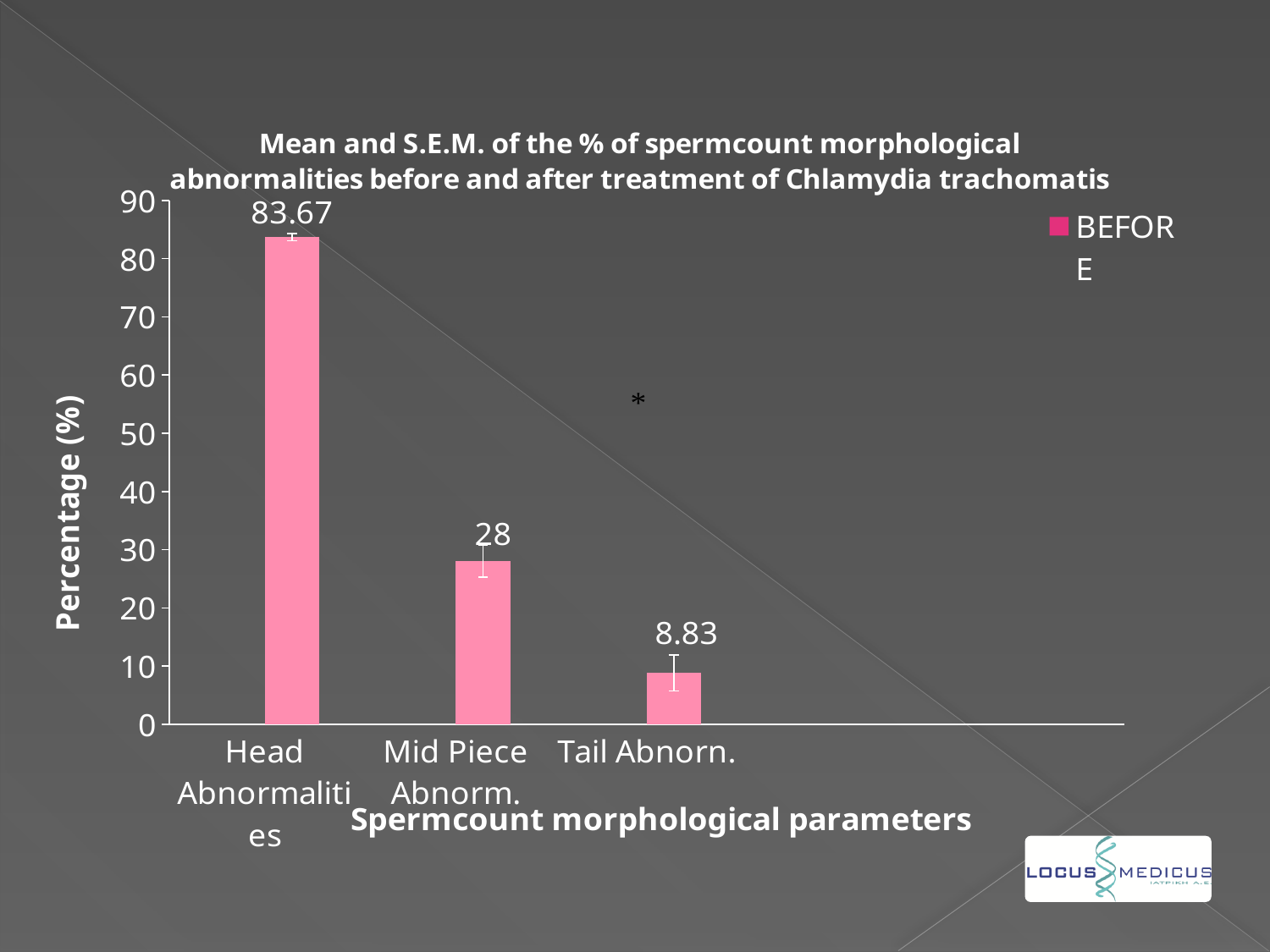
What is the label on the y axis? Percentage (%) What is the difference between the values for Mid Piece Abnorm. and Tail Abnorn.? 19.17 Which category has the lowest value? Tail Abnorn. What is the value for Head Abnormalities? 83.67 What is the value for Tail Abnorn.? 8.83 How many categories are shown on the x axis? 3 Which is larger, the value for Mid Piece Abnorm. or the value for Tail Abnorn.? Mid Piece Abnorm. Is the value for Mid Piece Abnorm. greater or less than 30? less What kind of chart is shown? bar chart What is the difference between the values for Head Abnormalities and Mid Piece Abnorm.? 55.67 Which category has the highest value? Head Abnormalities What is the value for Mid Piece Abnorm.? 28